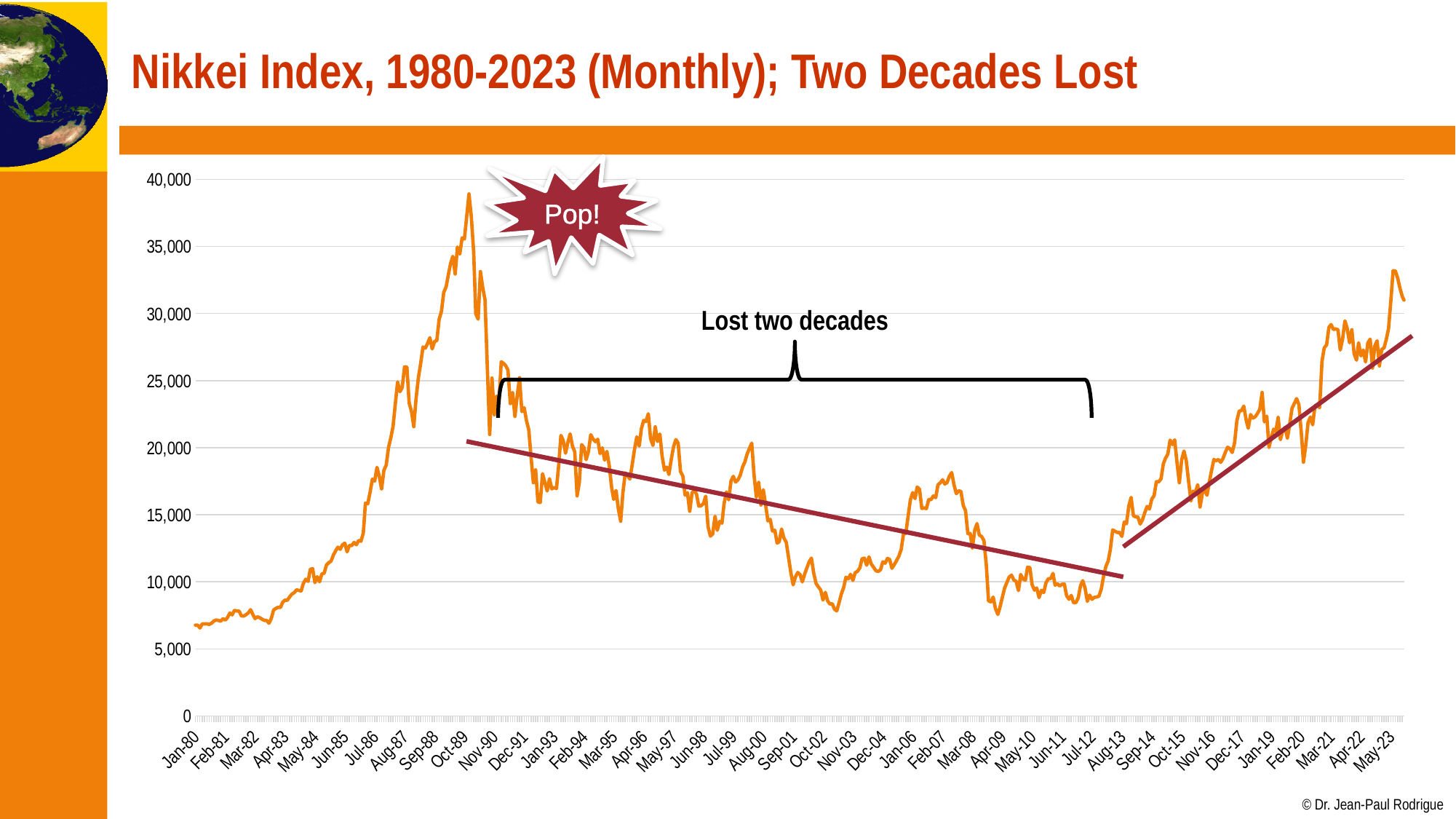
Is the value of the Nikkei Index at Apr-09 greater or less than 10,000? less Does the Nikkei Index generally rise or fall between Jan-80 and Oct-89? rise Near which x-axis label does the Nikkei Index line reach its highest point? Oct-89 Is the value of the Nikkei Index at Aug-13 greater or less than 15,000? less Does the Nikkei Index generally rise or fall between Aug-13 and May-23? rise Is the value of the Nikkei Index at Jan-80 greater or less than 10,000? less What kind of chart is shown on the slide? line chart Which is larger, the Nikkei Index value at Jan-80 or at May-23? May-23 What is the title of the chart on the slide? Nikkei Index, 1980-2023 (Monthly); Two Decades Lost What text is written inside the starburst callout near the peak of the line? Pop!